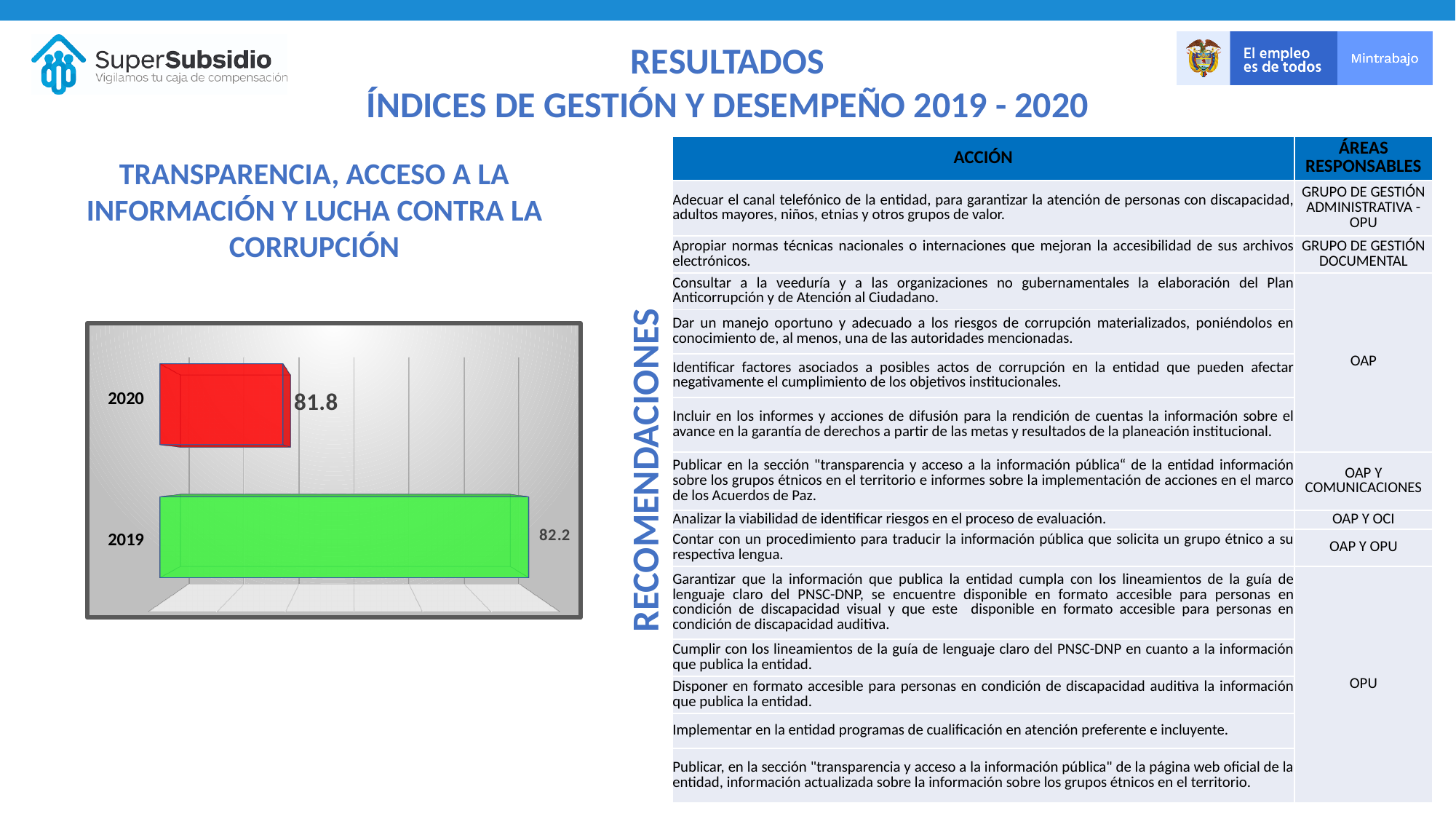
What is the difference between the 2019 value and the 2020 value in the chart? 0.4 What colour is the bar for 2019? green What is the value shown for 2020 in the chart? 81.8 Is the value for 2019 larger or smaller than the value for 2020? larger Which year has the lower value in the chart? 2020 What kind of chart is shown on the slide? bar chart Which year has the higher value in the chart? 2019 How many years (categories) are plotted in the chart? 2 What colour is the bar for 2020? red What is the value shown for 2019 in the chart? 82.2 Did the value rise or fall from 2019 to 2020? fall